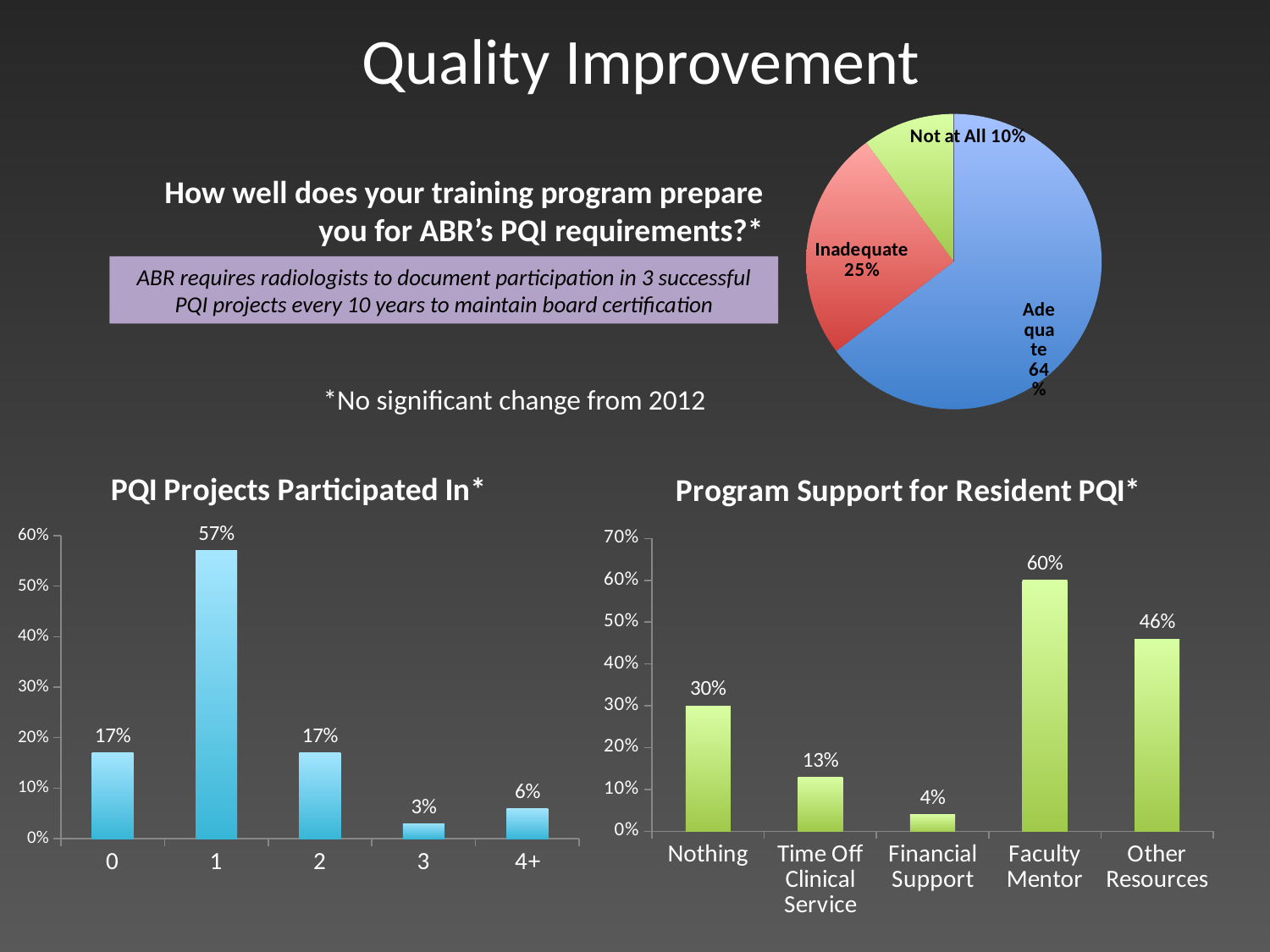
In the 'PQI Projects Participated In*' chart, what is the difference between the values for 1 and 0? 40% In the pie chart at the top right, what share of respondents answered Not at All? 10% In the 'Program Support for Resident PQI*' chart, what is the value for Faculty Mentor? 60% How many categories are shown in the 'PQI Projects Participated In*' chart? 5 What type of chart is 'Program Support for Resident PQI*'? Bar chart In the pie chart at the top right, which response has the largest slice? Adequate In the 'PQI Projects Participated In*' chart, what is the value for 1 project? 57% How many slices does the pie chart at the top right have? 3 In the 'Program Support for Resident PQI*' chart, what is the difference between Other Resources and Financial Support? 42% In the 'Program Support for Resident PQI*' chart, which is larger: Nothing or Time Off Clinical Service? Nothing In the pie chart at the top right, what share of respondents answered Inadequate? 25% In the 'PQI Projects Participated In*' chart, which category has the lowest value? 3